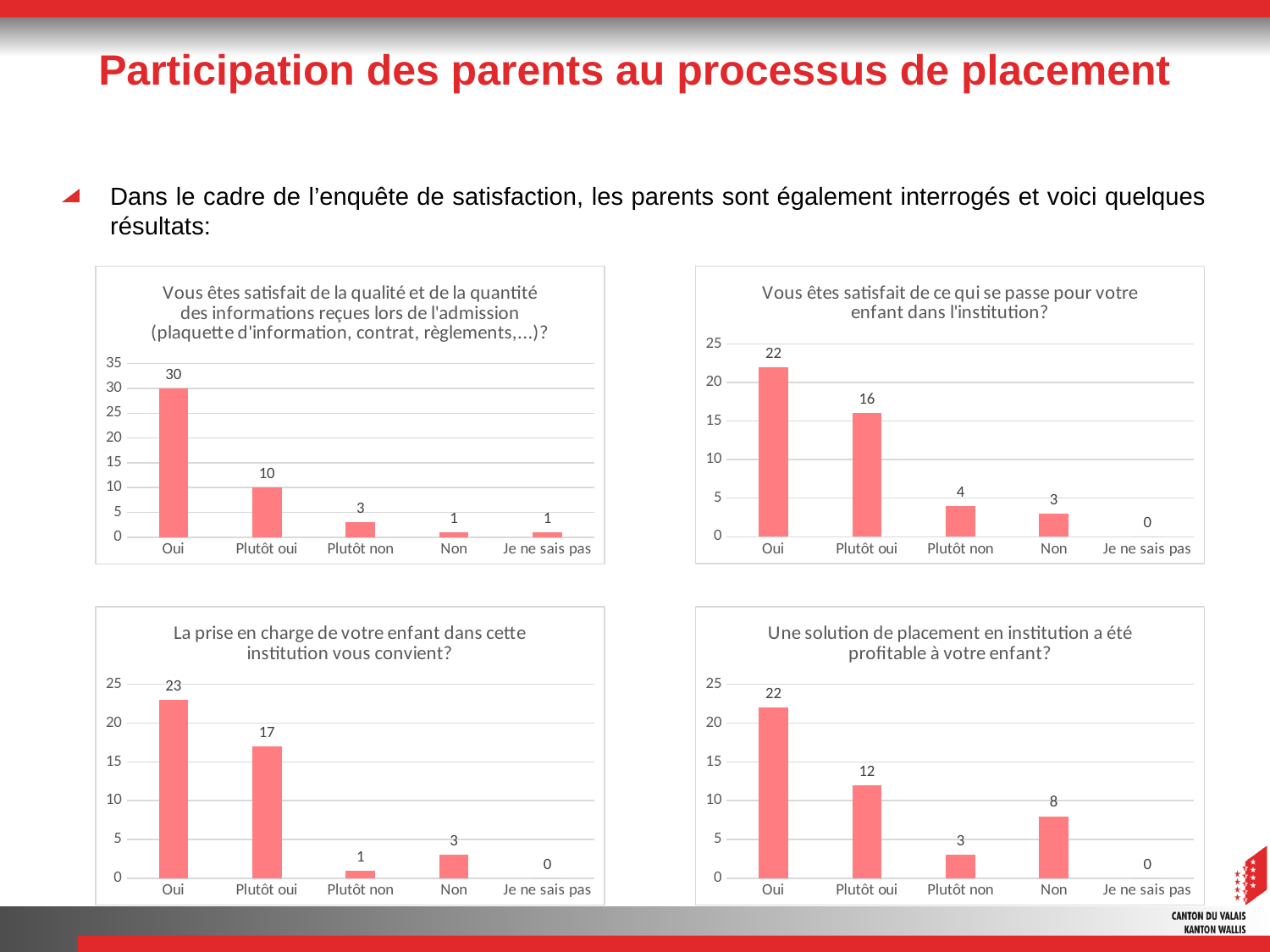
In the bottom-left chart ("La prise en charge de votre enfant dans cette institution vous convient?"), what is the value for "Non"? 3 In the bottom-left chart ("La prise en charge de votre enfant dans cette institution vous convient?"), which category has the highest value? Oui In the top-left chart (satisfaction with information received at admission), what is the difference between "Oui" and "Plutôt oui"? 20 In the bottom-right chart ("Une solution de placement en institution a été profitable à votre enfant?"), which is larger, "Plutôt oui" or "Non"? Plutôt oui In the bottom-right chart ("Une solution de placement en institution a été profitable à votre enfant?"), what is the value for "Non"? 8 In the bottom-left chart ("La prise en charge de votre enfant dans cette institution vous convient?"), what is the value for "Je ne sais pas"? 0 How many categories are shown on the x axis of the top-left chart? 5 In the top-right chart ("Vous êtes satisfait de ce qui se passe pour votre enfant dans l'institution?"), what is the value for "Plutôt oui"? 16 In the top-left chart (satisfaction with information received at admission), which category has the lowest value? Non and Je ne sais pas (both 1) What kind of chart is the top-right chart ("Vous êtes satisfait de ce qui se passe pour votre enfant dans l'institution?")? Bar chart In the top-left chart (satisfaction with quality and quantity of information received at admission), what is the value for "Oui"? 30 In the top-right chart ("Vous êtes satisfait de ce qui se passe pour votre enfant dans l'institution?"), what is the difference between "Oui" and "Plutôt oui"? 6